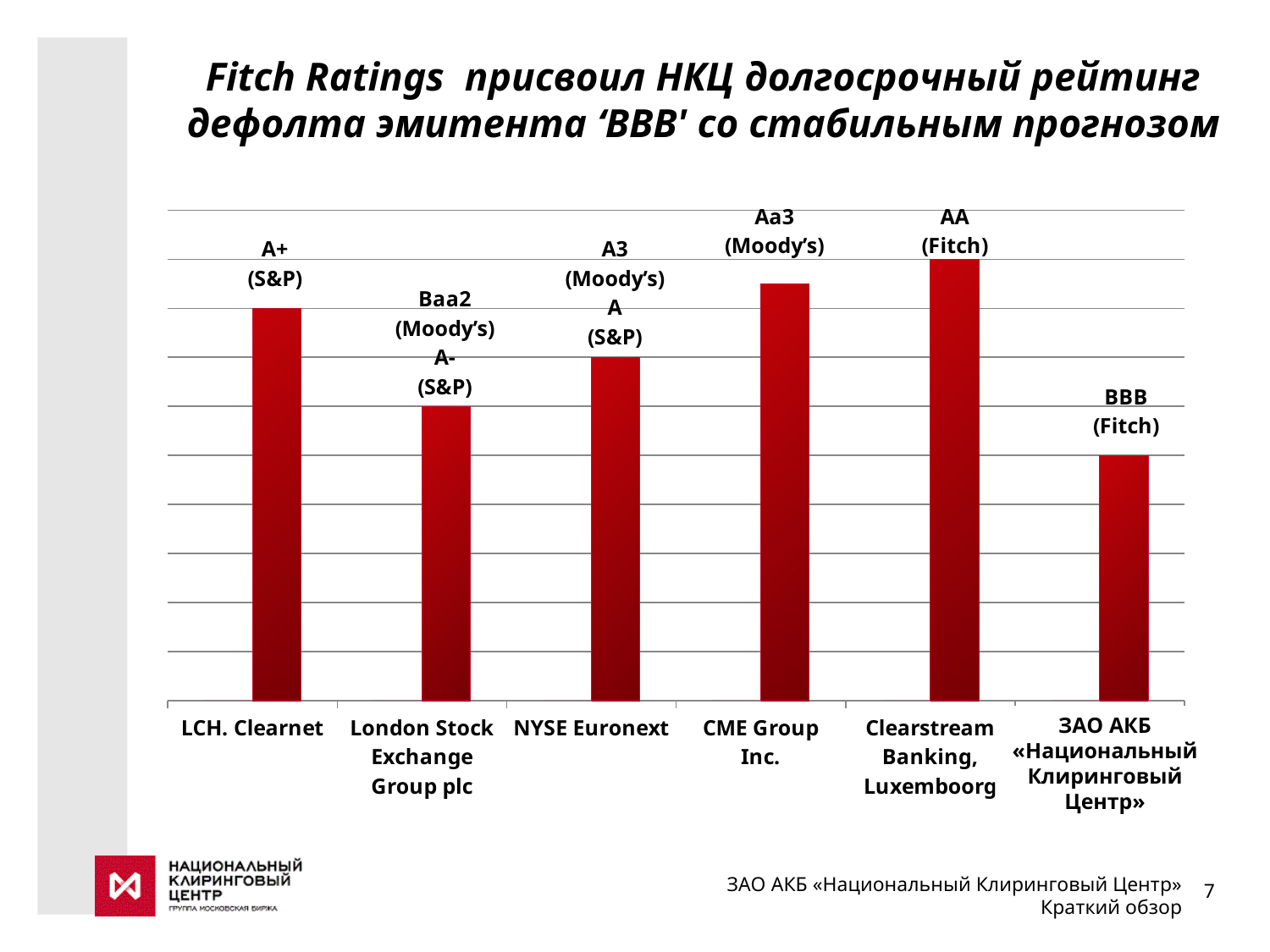
Which organisation has the shortest bar in the chart? ЗАО АКБ «Национальный Клиринговый Центр» Which organisation has the tallest bar in the chart? Clearstream Banking, Luxemboorg What Moody's rating is shown above the bar for CME Group Inc.? Aa3 Which bar is taller: CME Group Inc. or NYSE Euronext? CME Group Inc. What rating label is shown above the bar for LCH. Clearnet? A+ (S&P) What Moody's rating is shown above the bar for NYSE Euronext? A3 What rating label is shown above the bar for Clearstream Banking, Luxemboorg? AA (Fitch) Which bar is taller: LCH. Clearnet or London Stock Exchange Group plc? LCH. Clearnet What kind of chart is shown on the slide? bar chart What S&P rating is shown above the bar for London Stock Exchange Group plc? A- What rating label is shown above the bar for ЗАО АКБ «Национальный Клиринговый Центр»? BBB (Fitch) How many organisations (bars) are shown in the chart? 6